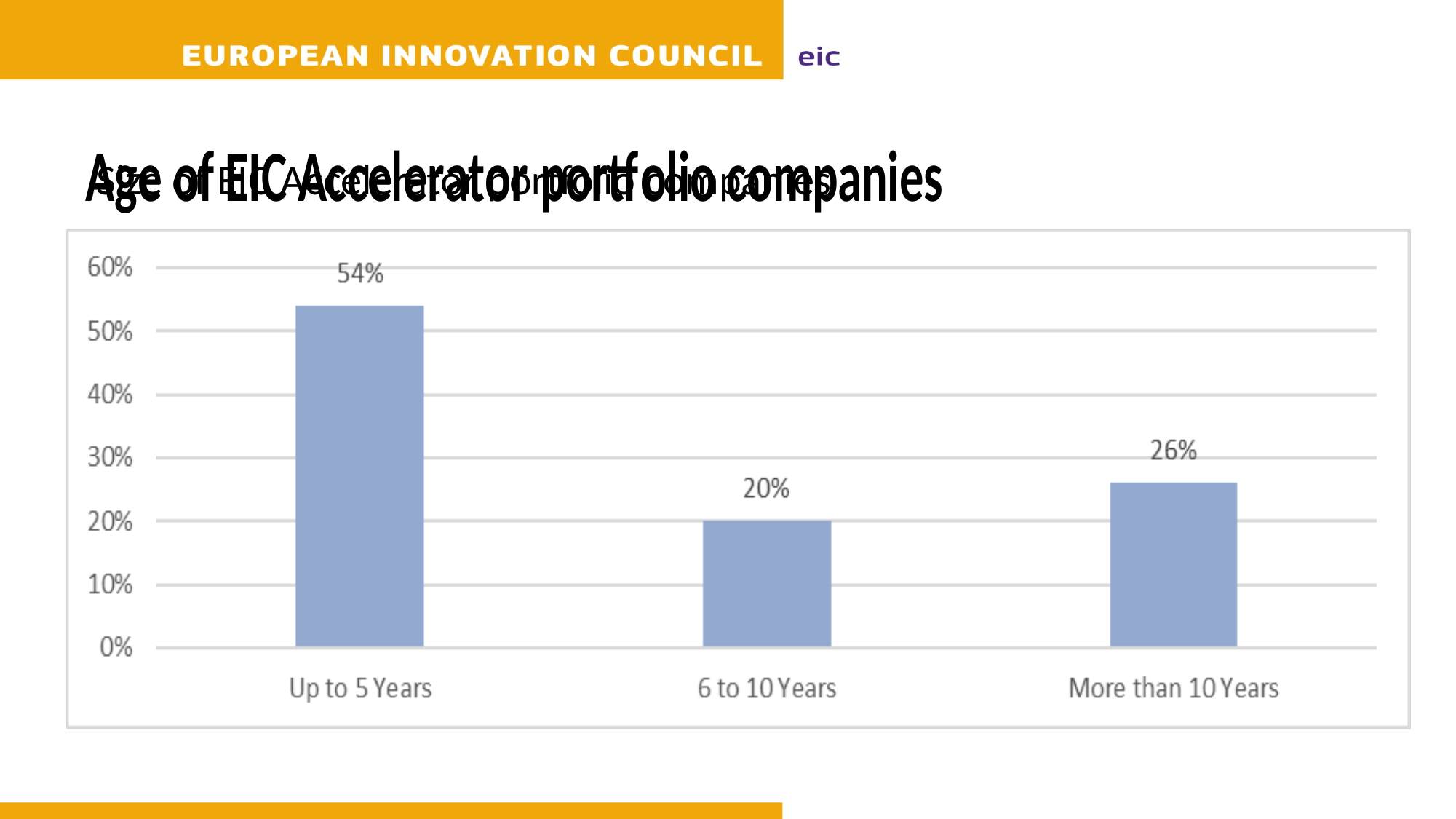
Which is larger: the value for '6 to 10 Years' or for 'More than 10 Years'? More than 10 Years What percentage of EIC Accelerator portfolio companies are up to 5 years old? 54% What is the title of the slide? Age of EIC Accelerator portfolio companies What is the value shown for the '6 to 10 Years' category? 20% What is the difference between the 'Up to 5 Years' and 'More than 10 Years' values? 28% Which age category has the lowest share of companies? 6 to 10 Years Is the value for 'Up to 5 Years' greater or less than 50%? greater What is the difference between the 'More than 10 Years' and '6 to 10 Years' values? 6% Which age category has the highest share of companies? Up to 5 Years How many age categories are shown on the chart? 3 What kind of chart is shown on the slide? Bar chart What is the value shown for the 'More than 10 Years' category? 26%